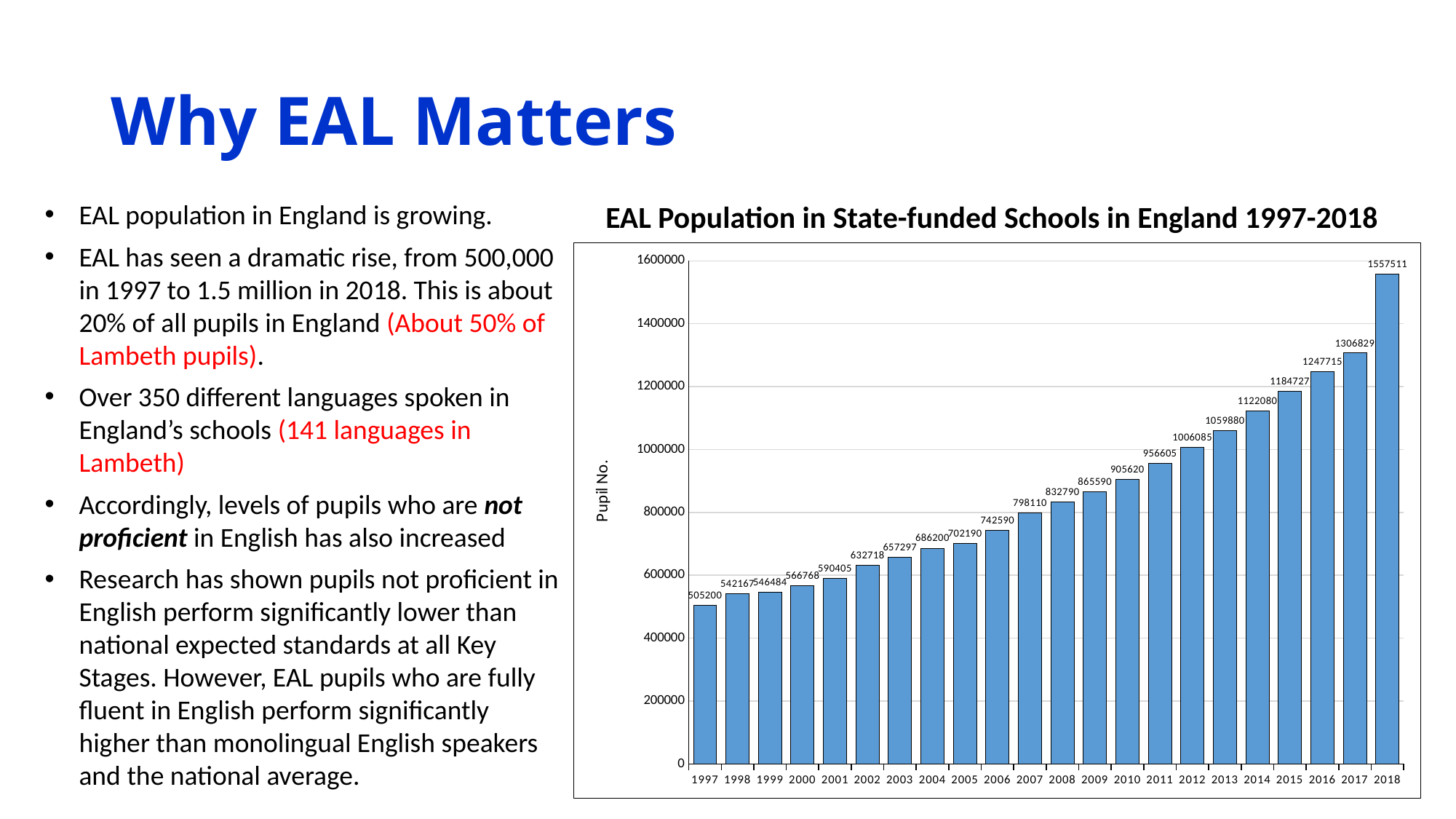
Do the EAL pupil numbers rise or fall from 1997 to 2018? Rise What is the difference between the EAL pupil numbers for 2018 and 2017? 250682 Which year has the highest EAL pupil number? 2018 What is the EAL pupil number for 2010? 905620 What is the EAL pupil number for 2004? 686200 Which year has a larger EAL pupil number, 2006 or 2009? 2009 What type of chart is shown on the slide? Bar chart What is the EAL pupil number for 2018? 1557511 Which year has the lowest EAL pupil number? 1997 What is the EAL pupil number for 1997? 505200 How many years are shown on the x axis of the chart? 22 What is the difference between the EAL pupil numbers for 2012 and 2011? 49480